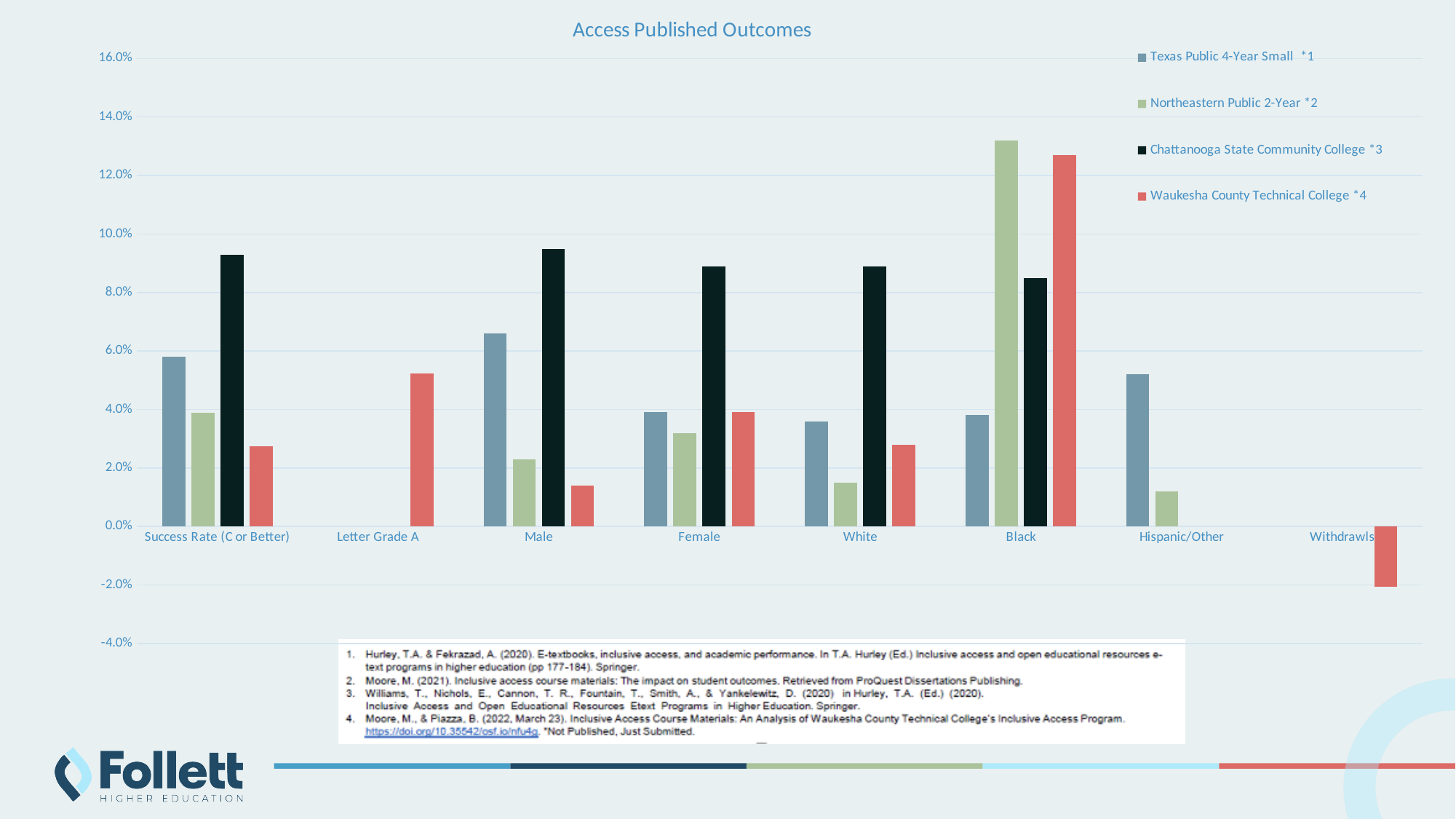
Which category has the highest value for Northeastern Public 2-Year? Black For Black, which is larger: Northeastern Public 2-Year or Chattanooga State Community College? Northeastern Public 2-Year What kind of chart is shown on the slide? bar chart Is the Texas Public 4-Year Small value for Male greater or less than 6.0%? greater How many series does the legend list? 4 Is the Northeastern Public 2-Year value for Black greater or less than 12.0%? greater What is the title of the chart? Access Published Outcomes How many categories are shown along the x axis? 8 For Success Rate (C or Better), which is larger: Chattanooga State Community College or Texas Public 4-Year Small? Chattanooga State Community College Which category has the lowest value for Waukesha County Technical College? Withdrawls Is the Chattanooga State Community College value for Male greater or less than 8.0%? greater